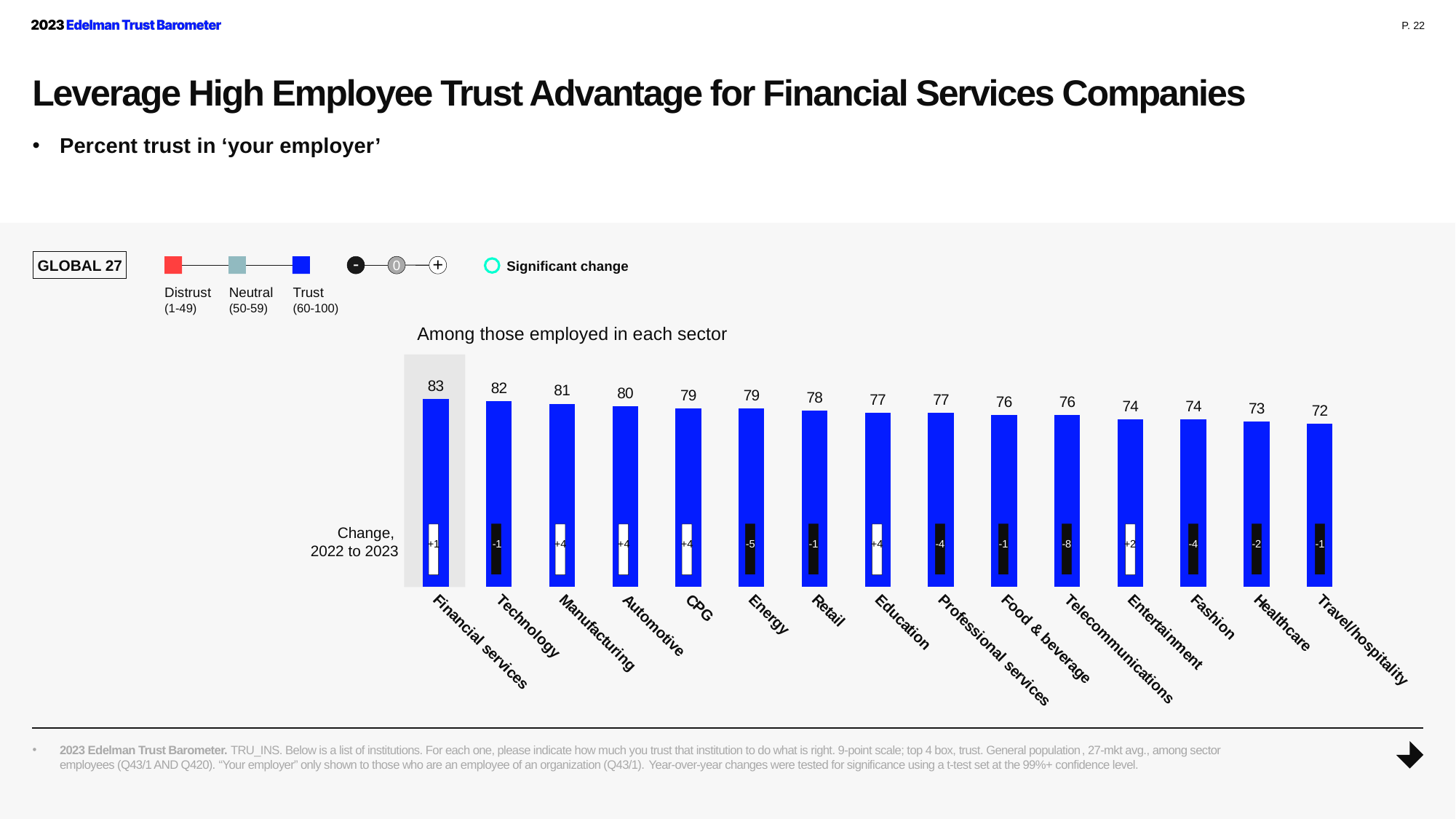
Which sector has the highest percent trust in 'your employer'? Financial services What kind of chart is used to show percent trust by sector? Bar chart What is the percent trust in 'your employer' among those employed in Healthcare? 73 Which has a higher percent trust in 'your employer': Technology or Retail? Technology What is the subtitle printed above the bars? Among those employed in each sector How many sectors are shown in the chart? 15 What is the percent trust in 'your employer' among those employed in Financial services? 83 Which sector has the lowest percent trust in 'your employer'? Travel/hospitality What is the change from 2022 to 2023 shown for Manufacturing? +4 What is the change from 2022 to 2023 shown for Telecommunications? -8 What is the difference in percent trust between Financial services and Travel/hospitality? 11 Do the trust values rise or fall moving from left to right across the sectors? Fall